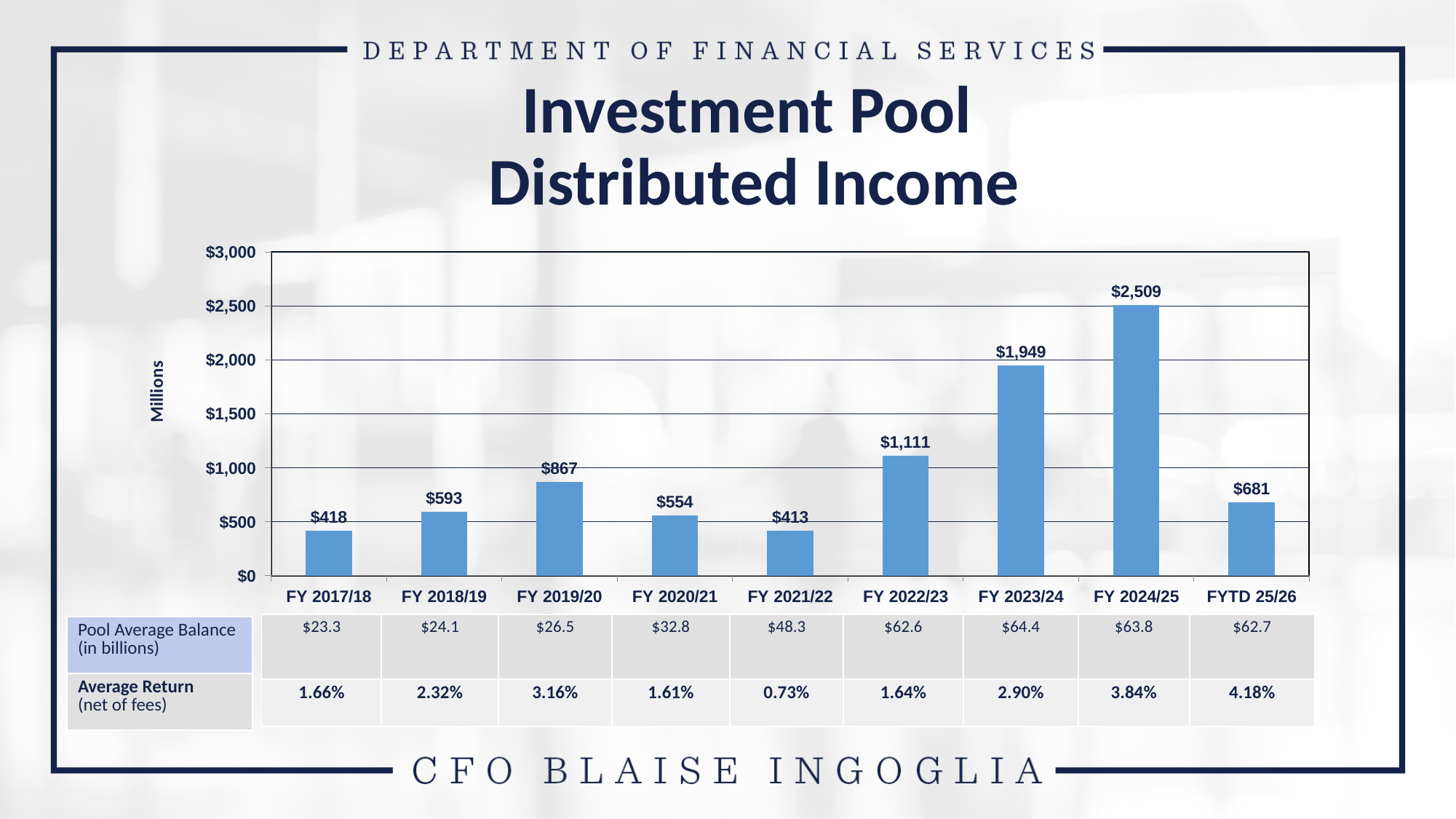
What is the distributed income value for FYTD 25/26? $681 What unit is indicated on the vertical axis label of the chart? Millions What is the difference in distributed income between FY 2024/25 and FY 2023/24? $560 What type of chart is shown on the slide? bar chart What is the distributed income value for FY 2019/20? $867 What is the distributed income value for FY 2024/25? $2,509 Which is larger, the distributed income for FY 2018/19 or FY 2020/21? FY 2018/19 What is the difference in distributed income between FY 2022/23 and FY 2021/22? $698 Which fiscal year has the lowest distributed income? FY 2021/22 How many fiscal year categories are shown in the chart? 9 Is the distributed income for FY 2023/24 greater or less than $1,500? greater Which fiscal year has the highest distributed income? FY 2024/25